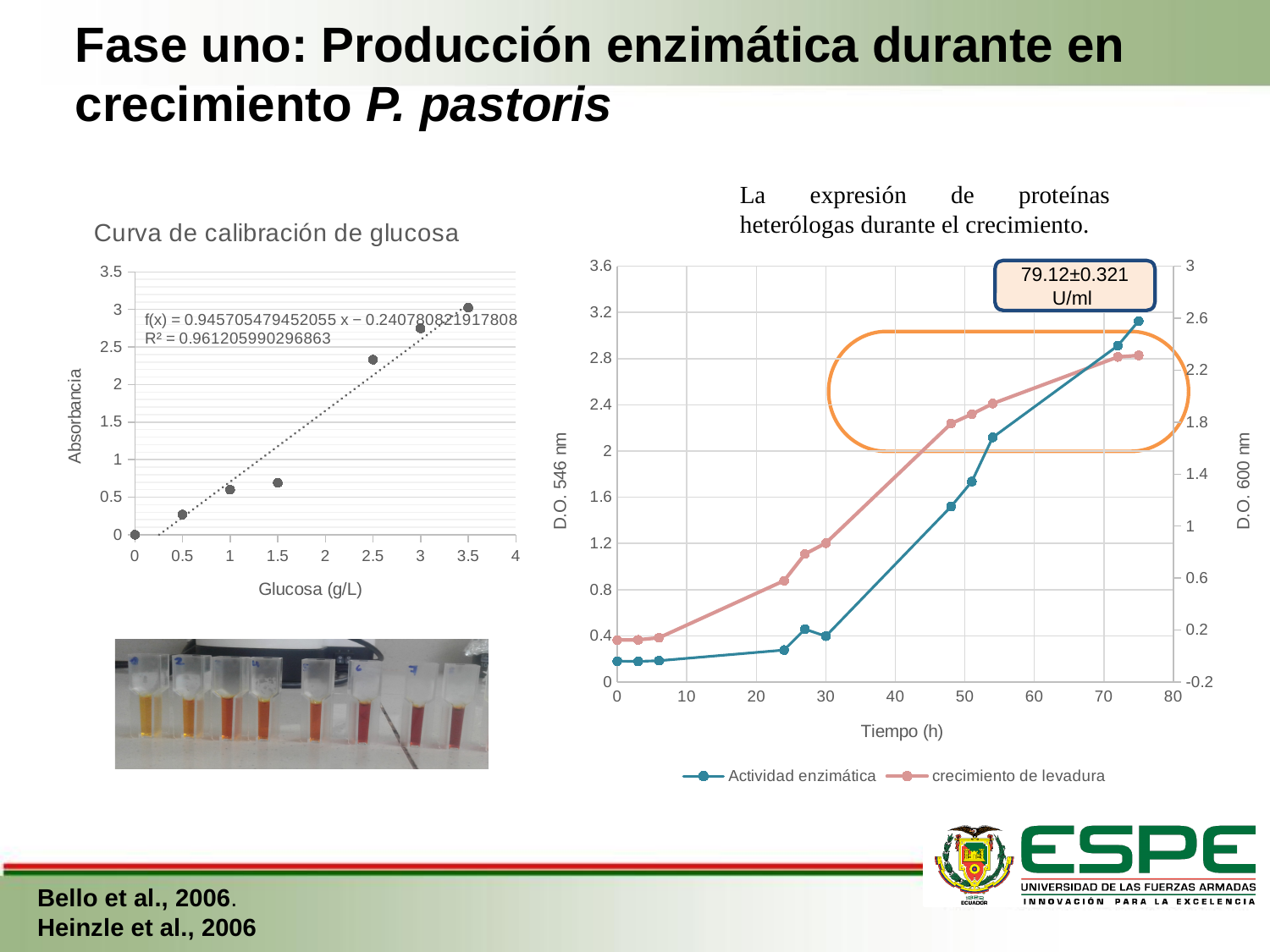
In the 'Curva de calibración de glucosa' chart, is the absorbance at 2.5 g/L glucose greater or less than 2? greater In the 'Curva de calibración de glucosa' chart, does absorbance rise or fall as glucose concentration increases? rise What kind of chart is the 'Curva de calibración de glucosa' chart? scatter chart What is the title of the chart on the left of the slide? Curva de calibración de glucosa In the 'Curva de calibración de glucosa' chart, is the absorbance at 1.5 g/L glucose greater or less than 1? less How many series does the legend of the chart on the right of the slide list? 2 In the chart on the right of the slide, does the 'Actividad enzimática' series rise or fall over time? rise What kind of chart is the chart on the right of the slide? line chart In the 'Curva de calibración de glucosa' chart, what is the label of the x axis? Glucosa (g/L) In the 'Curva de calibración de glucosa' chart, what is the R² value shown? 0.961205990296863 In the chart on the right of the slide, how many data points are plotted for the 'Actividad enzimática' series? 11 How many data points are plotted in the 'Curva de calibración de glucosa' chart? 7